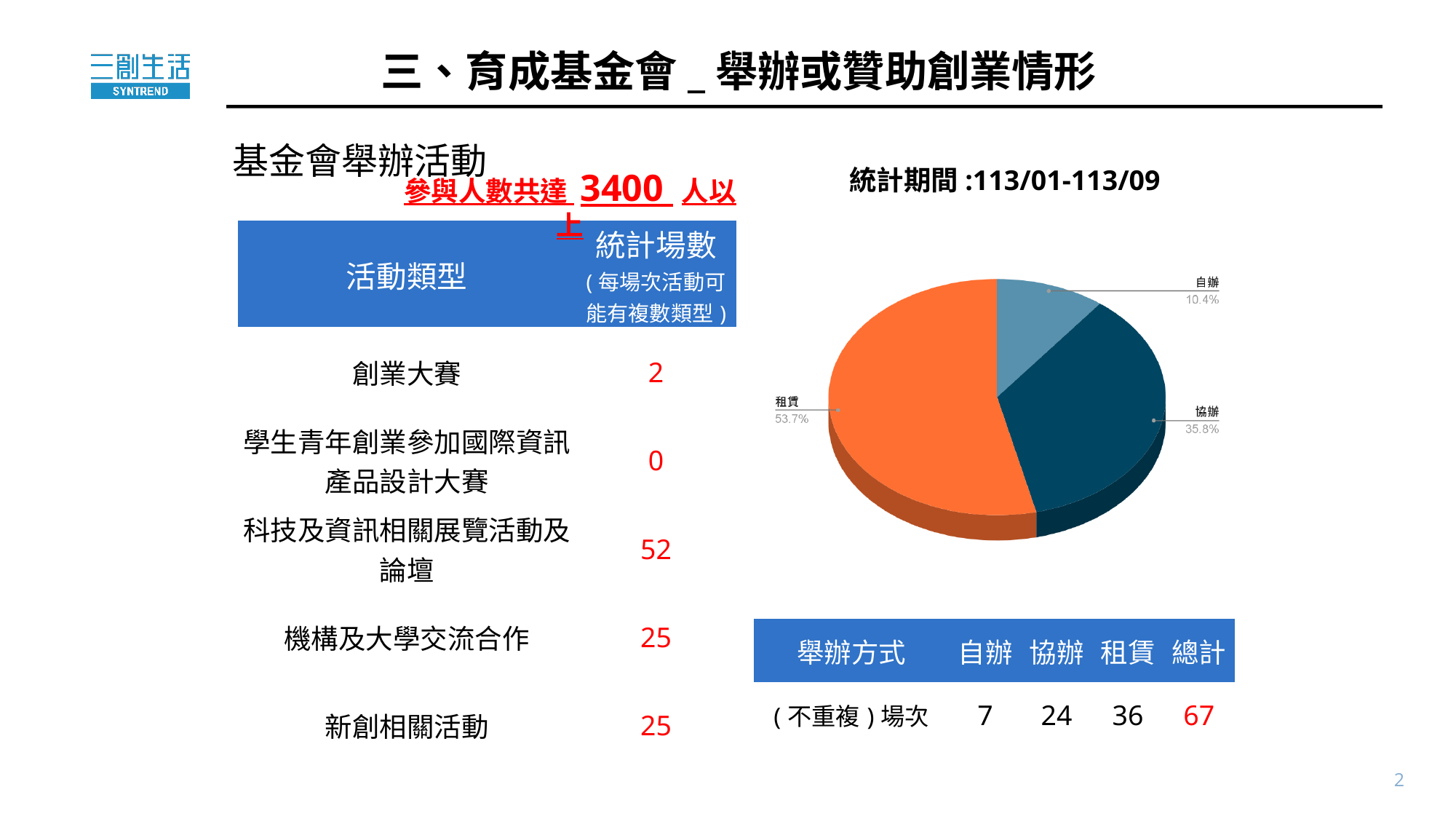
What colour is the 租賃 slice in the pie chart? orange Which slice of the pie chart is the largest? 租賃 What is the difference in percentage points between the 協辦 and 自辦 slices? 25.4 What share of the pie chart does 協辦 represent? 35.8% What kind of chart is shown on the slide? pie chart Which is larger in the pie chart, 協辦 or 自辦? 協辦 What share of the pie chart does 自辦 represent? 10.4% What statistical period is stated above the pie chart? 113/01-113/09 How many slices does the pie chart have? 3 What is the difference in percentage points between the 租賃 and 協辦 slices? 17.9 What share of the pie chart does 租賃 represent? 53.7% Which slice of the pie chart is the smallest? 自辦